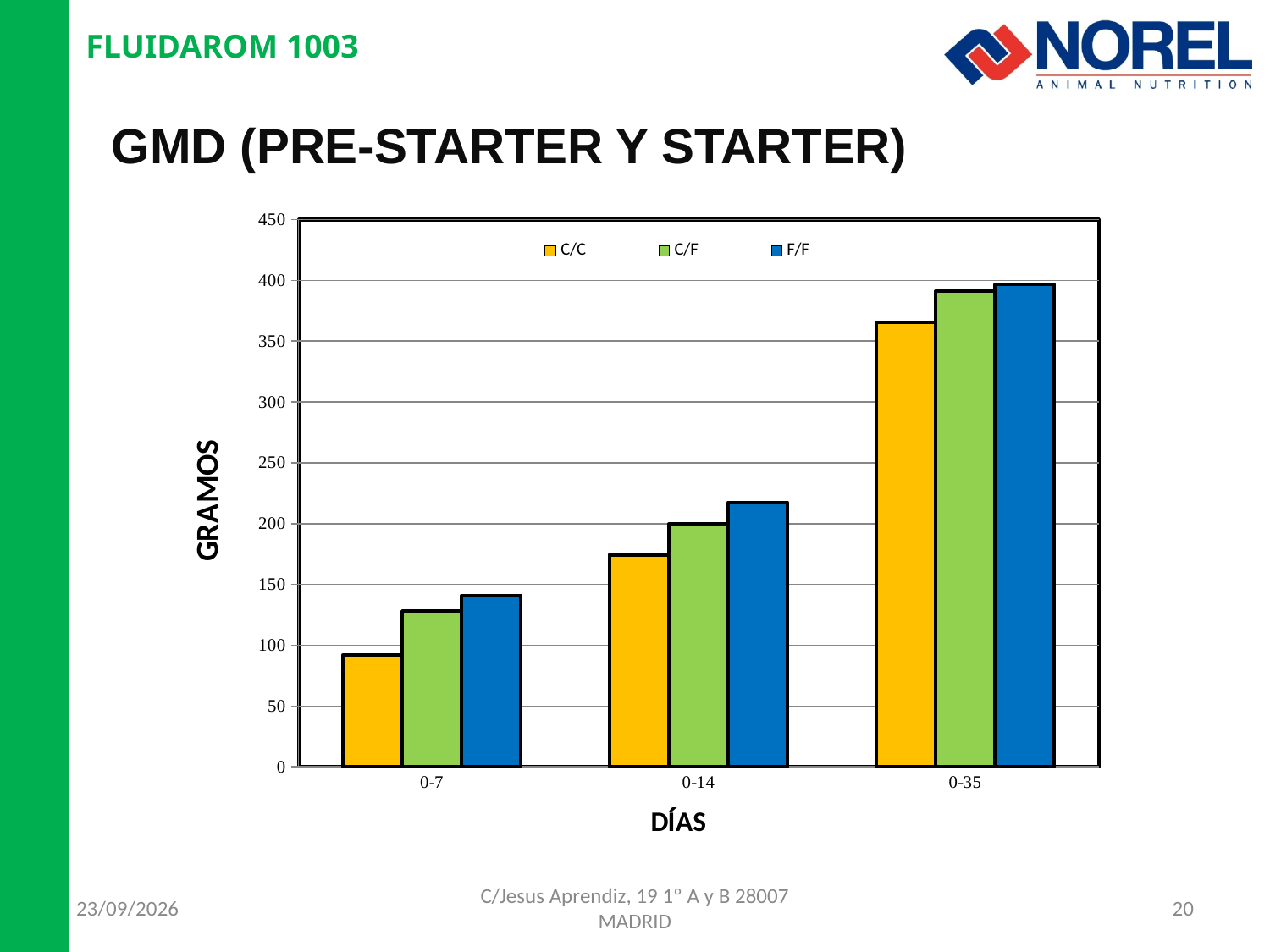
Is the value for C/C in the 0-35 category greater or less than 350? greater Which series has the lowest value for the 0-35 category? C/C Is the value for C/F in the 0-7 category greater or less than 150? less What kind of chart is shown on the slide? bar chart How many series does the legend list? 3 How many categories are shown on the x axis? 3 Which is larger in the 0-35 category, C/C or F/F? F/F Is the value for F/F in the 0-14 category greater or less than 200? greater What is the label of the y axis? GRAMOS Do the values for the C/C series rise or fall from 0-7 to 0-35? rise Which series has the highest value for the 0-7 category? F/F